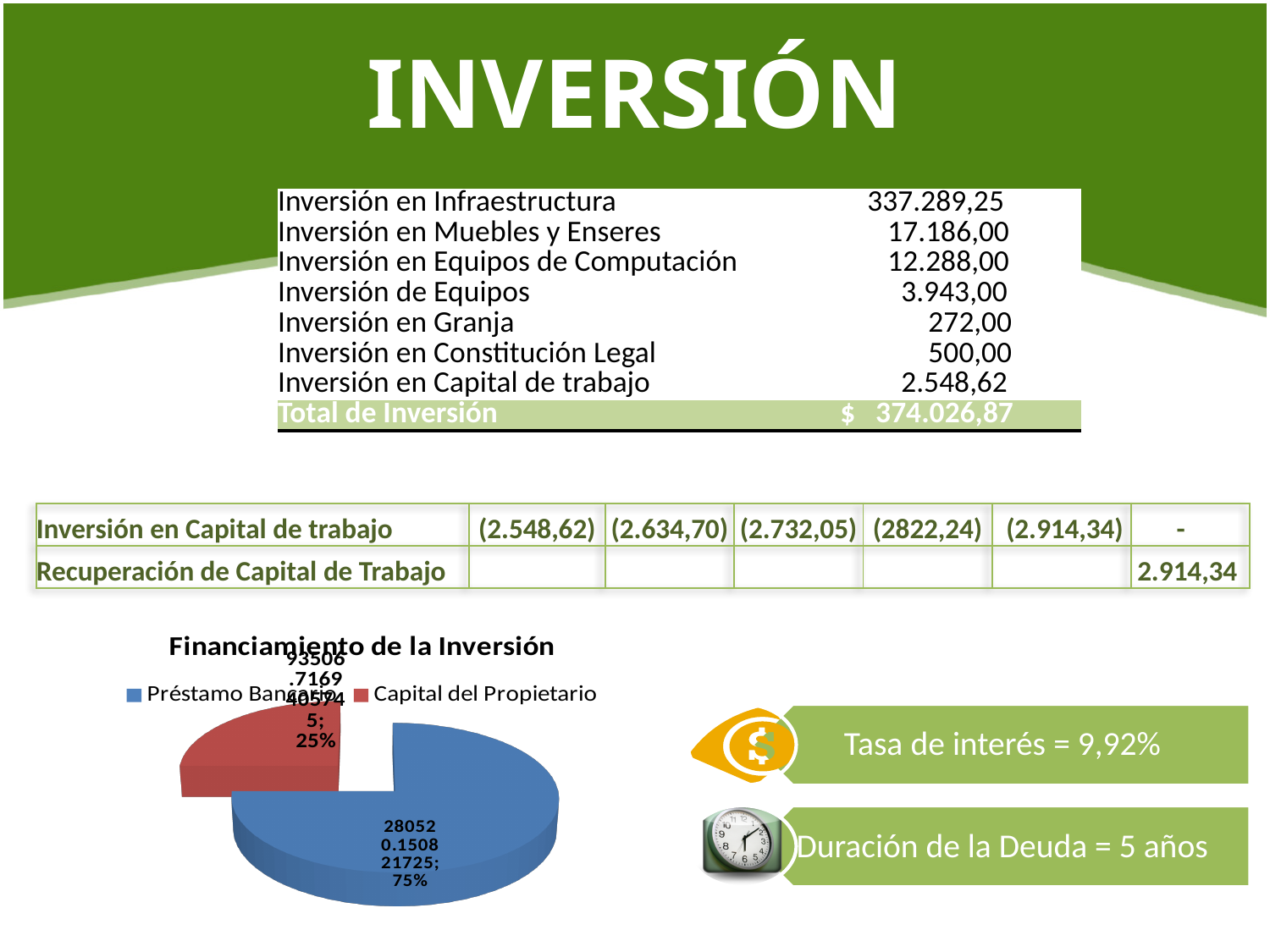
Which slice of the pie chart is the smallest? Capital del Propietario What share of the pie chart does Capital del Propietario represent? 25% How many slices does the pie chart have? 2 What kind of chart is shown under the title "Financiamiento de la Inversión"? pie chart What share of the pie chart does Préstamo Bancario represent? 75% What colour is the Préstamo Bancario slice in the pie chart? blue Which slice of the pie chart is the largest? Préstamo Bancario What is the difference in percentage points between the Préstamo Bancario and Capital del Propietario shares in the pie chart? 50% What is the title of the pie chart on the slide? Financiamiento de la Inversión How many series does the legend of the pie chart list? 2 In the pie chart, which is larger: Préstamo Bancario or Capital del Propietario? Préstamo Bancario